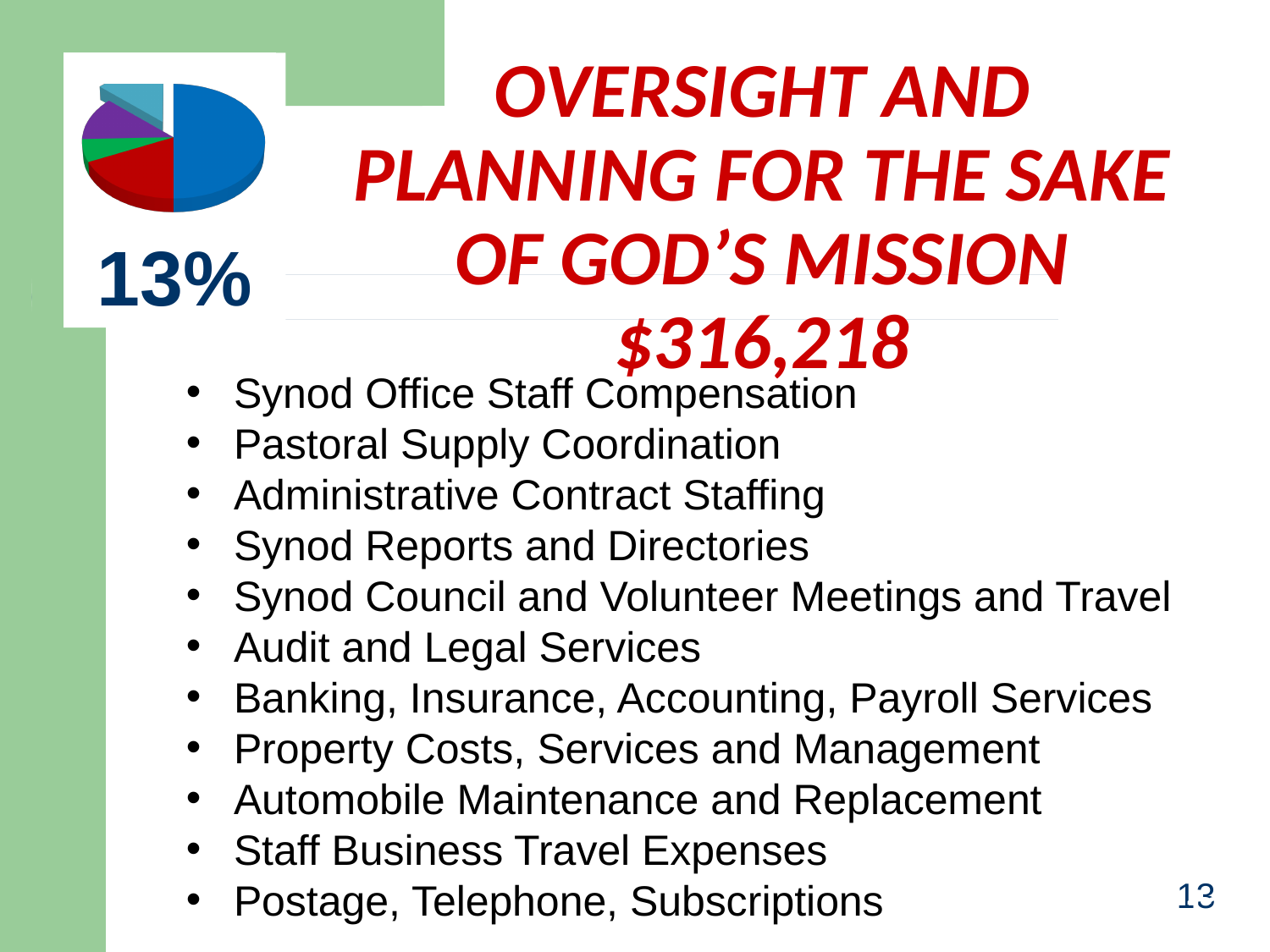
How many slices does the pie chart have? 5 Which colour slice is pulled out (exploded) from the pie chart? light blue What percentage is printed beside the pie chart? 13% What kind of chart is shown on the slide? pie chart Is the red slice larger or smaller than the green slice? larger Is the blue slice larger or smaller than the red slice? larger Which colour slice is the largest in the pie chart? blue